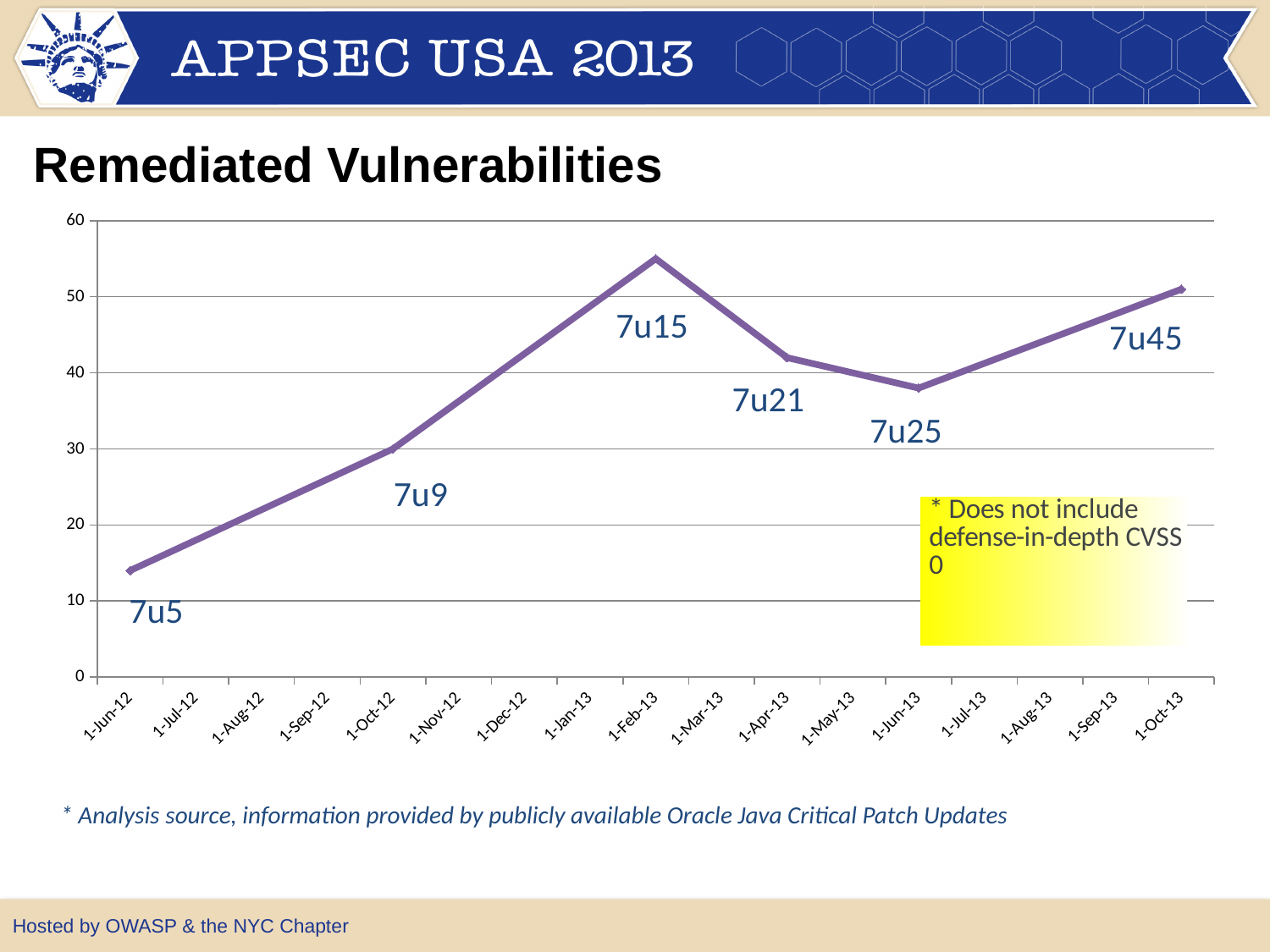
Is the value for 7u25 greater or less than 40? less What kind of chart is shown on the slide? line chart Is the value for 7u15 greater or less than 50? greater Is the value for 7u5 greater or less than 20? less What does the yellow note on the chart say is not included? defense-in-depth CVSS 0 How many labeled data points are plotted on the line? 6 Which labeled point has the highest value? 7u15 Which labeled point has the lowest value? 7u5 What is the title of the chart on the slide? Remediated Vulnerabilities Do the values rise or fall from 7u5 to 7u15? rise Which has the larger value, 7u21 or 7u45? 7u45